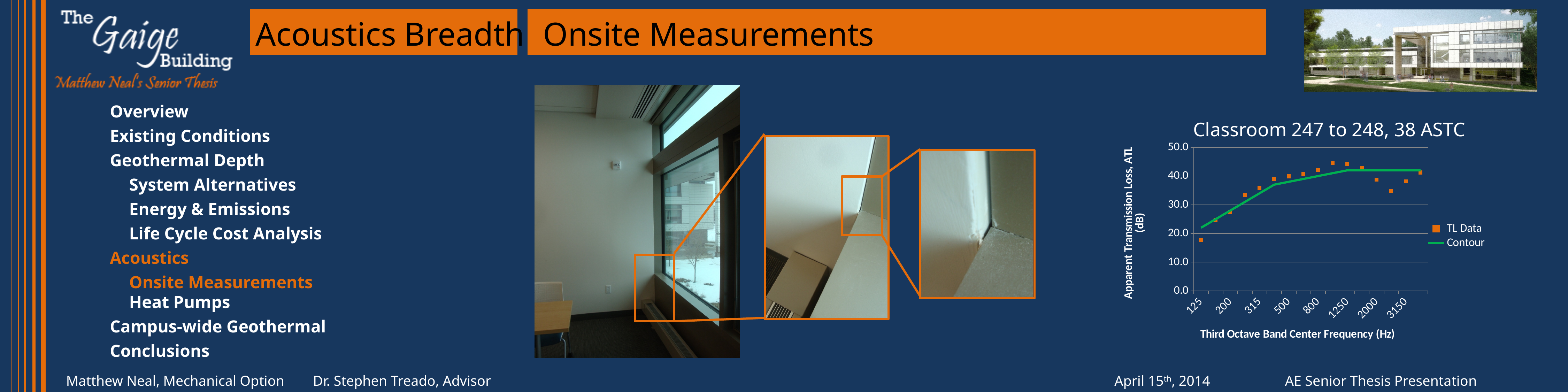
How many frequency labels are shown along the chart's x axis? 8 Is the TL Data value at 1250 Hz greater or less than 40? greater What is the highest value shown on the chart's y axis? 50.0 What is the title of the chart? Classroom 247 to 248, 38 ASTC What kind of chart is shown on the slide? Line chart Do the Contour values generally rise or fall as frequency increases from 125 Hz to 1250 Hz? rise Is the TL Data value at 125 Hz greater or less than 20? less How many series does the chart legend list? 2 What is the label of the chart's x axis? Third Octave Band Center Frequency (Hz) What are the two entries in the chart legend? TL Data and Contour What is the label of the chart's y axis? Apparent Transmission Loss, ATL (dB) Is the Contour value at 315 Hz greater or less than 30? greater